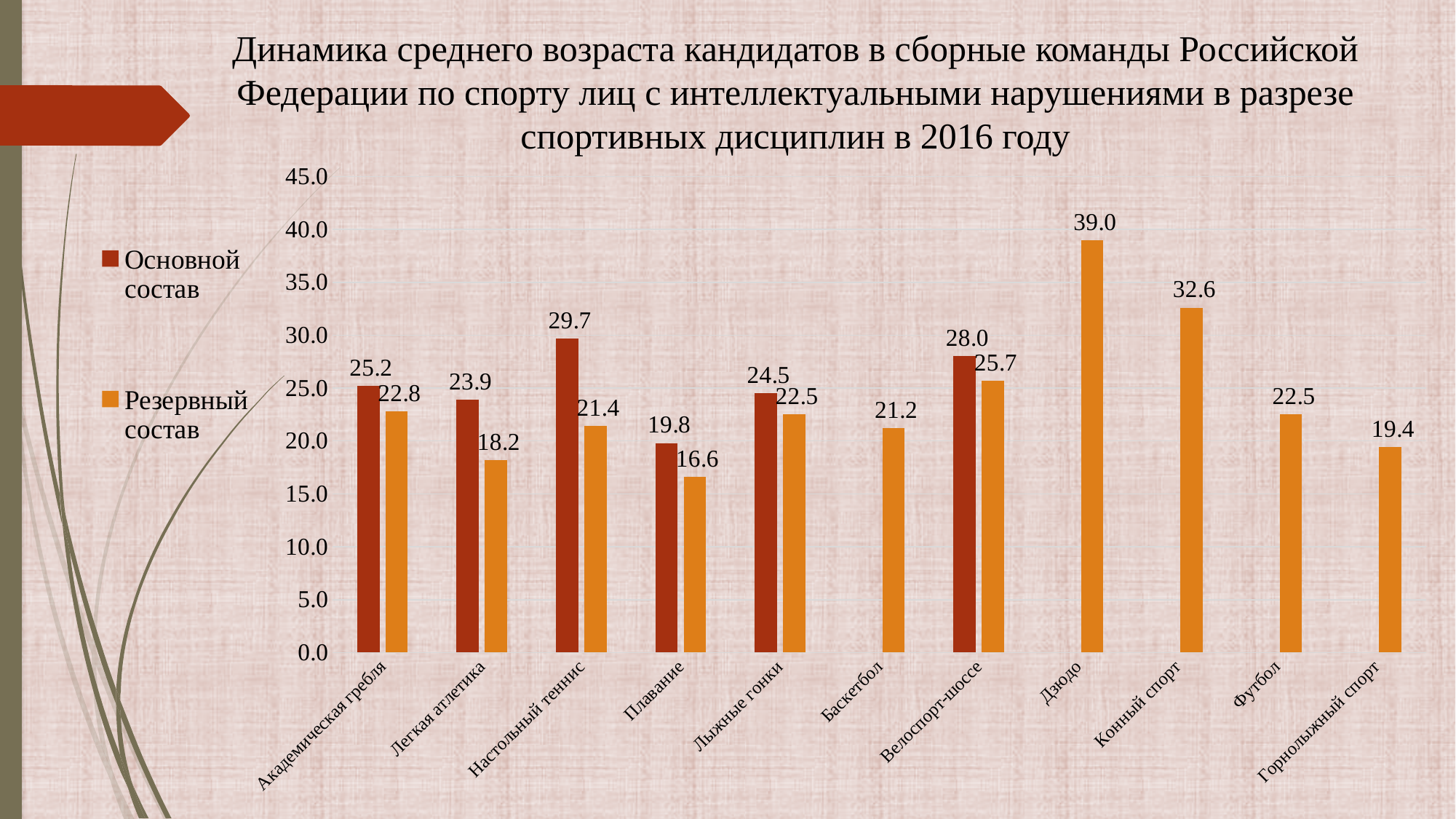
Which discipline has the highest value for Резервный состав? Дзюдо Which is larger in Велоспорт-шоссе: Основной состав or Резервный состав? Основной состав What type of chart is shown on the slide? bar chart Which colour represents Резервный состав in the legend? orange What is the value for Резервный состав in Дзюдо? 39.0 What is the value for Основной состав in Настольный теннис? 29.7 Which discipline has the lowest value for Основной состав? Плавание What is the difference between Основной состав and Резервный состав in Легкая атлетика? 5.7 Is the value for Резервный состав in Конный спорт greater or less than 30.0? greater What is the value for Резервный состав in Плавание? 16.6 How many series does the legend list? 2 How many sport disciplines (categories) are shown on the x axis? 11